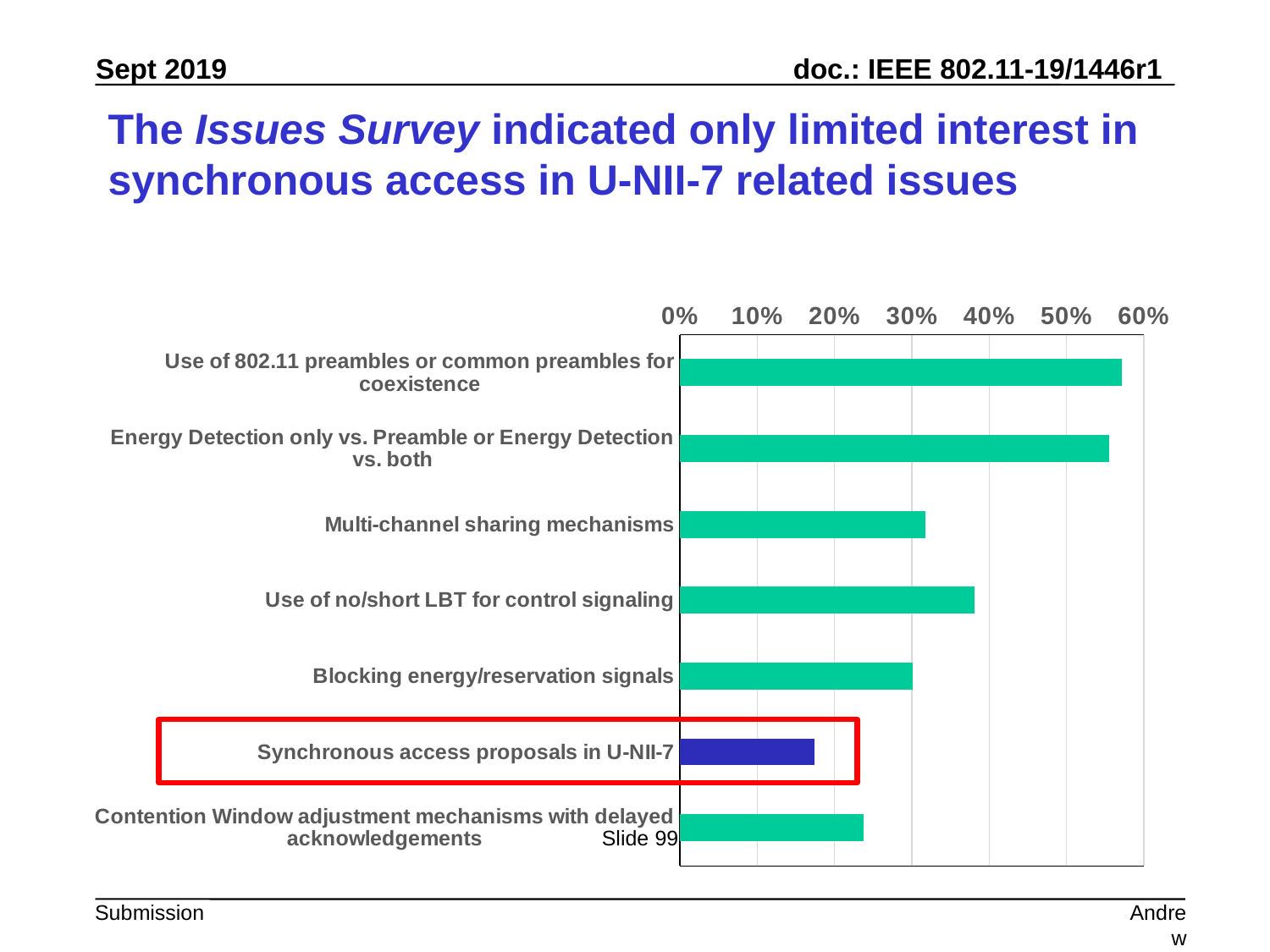
How many categories are plotted in the chart? 7 What is the highest value shown on the percentage axis of the chart? 60% Which has the larger value: Use of no/short LBT for control signaling or Multi-channel sharing mechanisms? Use of no/short LBT for control signaling Is the value for Use of 802.11 preambles or common preambles for coexistence greater or less than 50%? greater Which category's bar is drawn in a different colour (dark blue) and outlined with a red box? Synchronous access proposals in U-NII-7 Which category has the lowest value in the chart? Synchronous access proposals in U-NII-7 Which has the larger value: Contention Window adjustment mechanisms with delayed acknowledgements or Synchronous access proposals in U-NII-7? Contention Window adjustment mechanisms with delayed acknowledgements Is the value for Contention Window adjustment mechanisms with delayed acknowledgements greater or less than 20%? greater Is the value for Synchronous access proposals in U-NII-7 greater or less than 20%? less What kind of chart is shown on the slide? bar chart